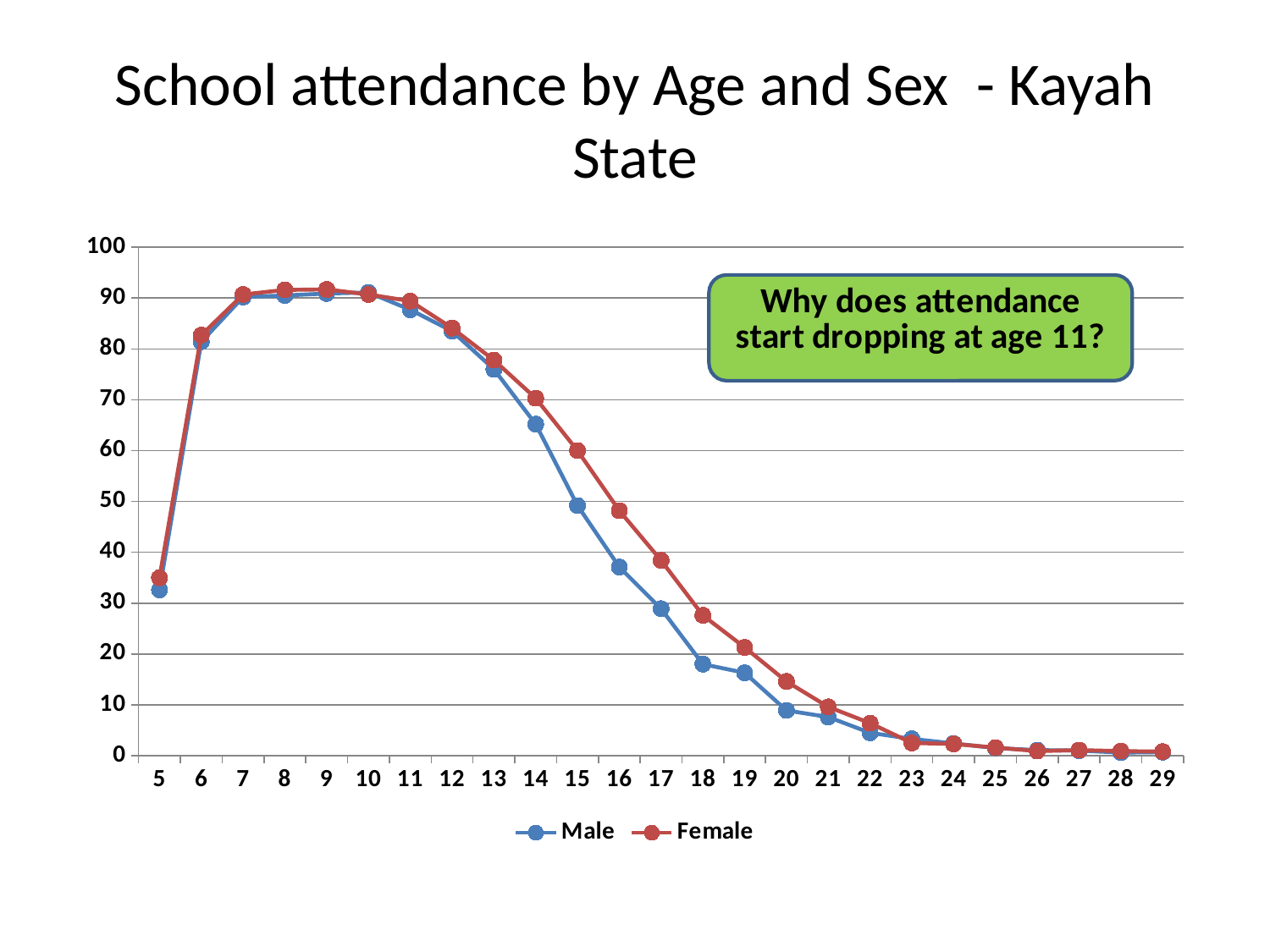
Is the Female value at age 17 greater or less than 40? less Is the Male value at age 18 greater or less than 20? less What kind of chart is shown on the slide? line chart Is the Male value at age 16 greater or less than 40? less At age 17, which series has the higher value, Male or Female? Female How many series does the legend list? 2 How many age categories are plotted along the x axis? 25 What is the title of the chart? School attendance by Age and Sex - Kayah State Do the Female values rise or fall from age 11 to age 29? fall At age 15, which series has the higher value, Male or Female? Female